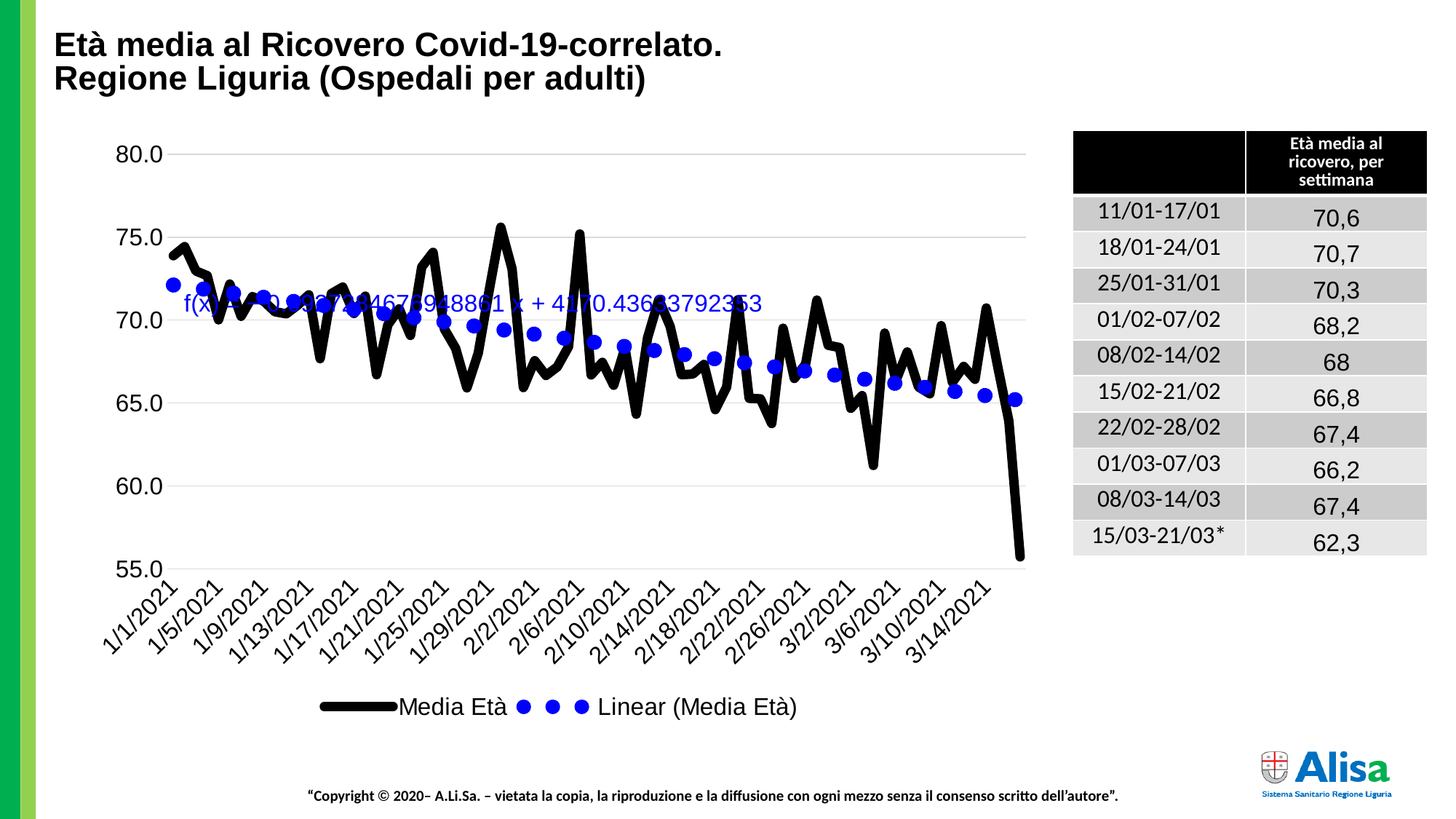
What is the title of the slide containing the chart? Età media al Ricovero Covid-19-correlato. Regione Liguria (Ospedali per adulti) What is the highest value shown on the chart's vertical axis? 80.0 What kind of chart is shown on the slide? line chart Does the Media Età line reach its lowest value at the beginning or at the end of the period? at the end Is the Media Età value at the last point of the series greater or less than 60.0? less What are the two entries in the chart legend? Media Età and Linear (Media Età) Is the Media Età value at 3/6/2021 greater or less than 65.0? greater Overall, do the Media Età values rise or fall from 1/1/2021 to the end of the period? fall Is the Media Età value at 1/1/2021 greater or less than 70.0? greater How many series does the chart legend list? 2